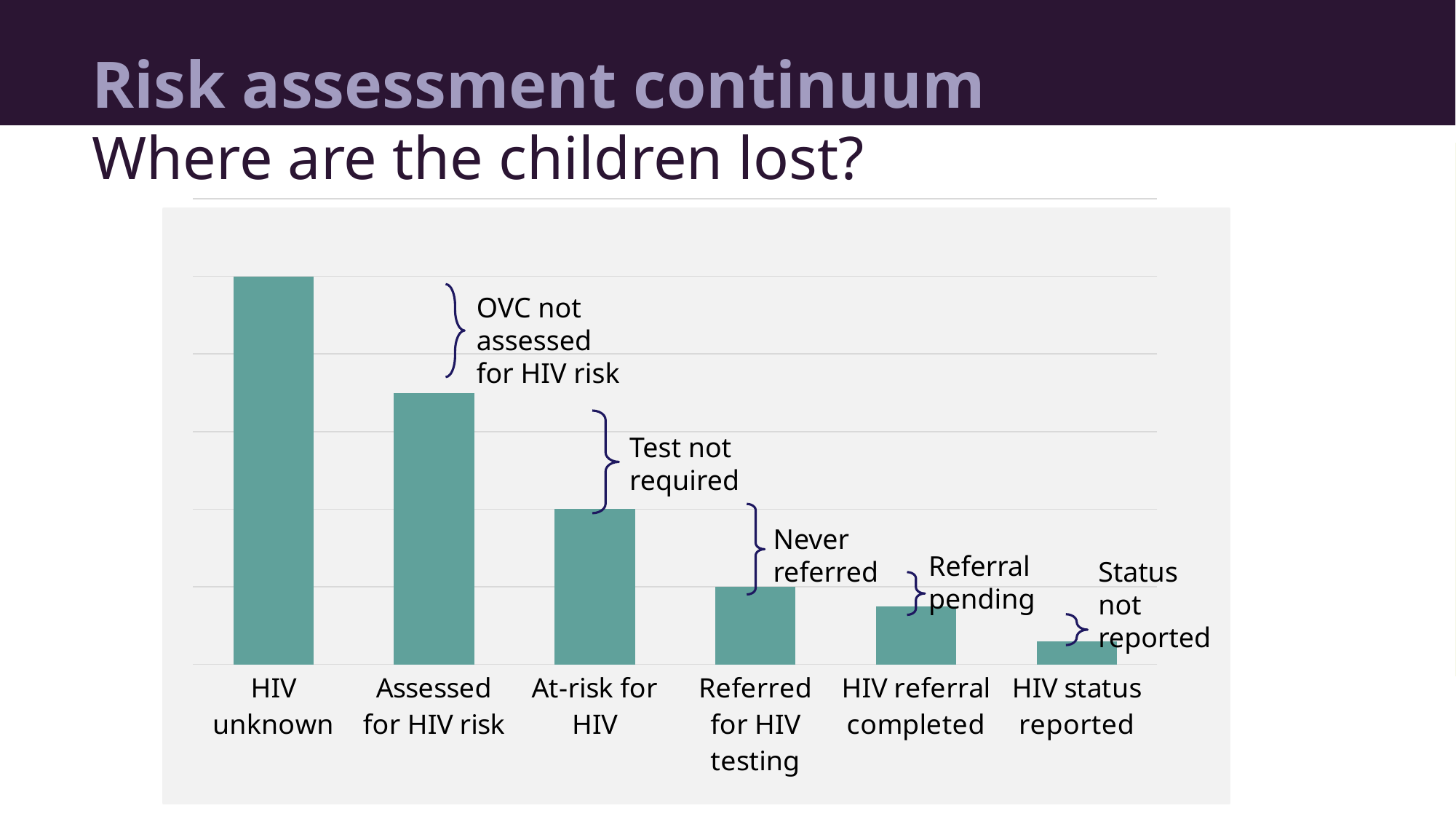
What annotation explains the drop between 'At-risk for HIV' and 'Referred for HIV testing'? Never referred Do the bar values rise or fall from left to right along the x axis? fall Which is larger: the bar for 'Assessed for HIV risk' or the bar for 'At-risk for HIV'? Assessed for HIV risk Which category has the shortest bar? HIV status reported What annotation explains the drop between 'HIV unknown' and 'Assessed for HIV risk'? OVC not assessed for HIV risk What is the label of the first (leftmost) category on the x axis? HIV unknown Which is larger: the bar for 'Referred for HIV testing' or the bar for 'HIV referral completed'? Referred for HIV testing What kind of chart is shown on the slide? bar chart Which category has the tallest bar? HIV unknown Which is larger: the bar for 'HIV unknown' or the bar for 'HIV status reported'? HIV unknown How many categories (bars) does the chart show? 6